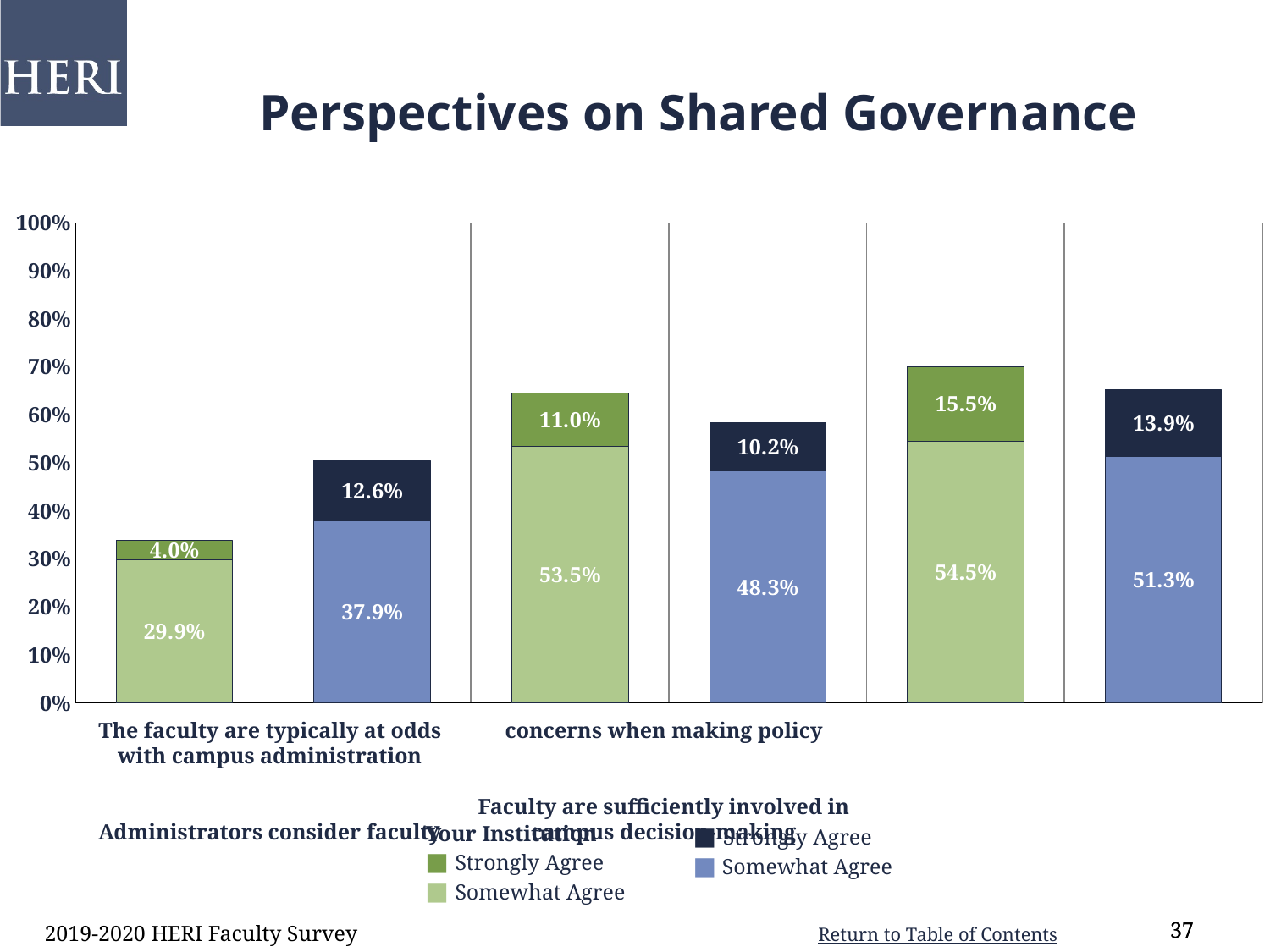
What is the total percentage agreeing (strongly plus somewhat) for Your Institution that faculty are sufficiently involved in campus decision making? 70.0% What percentage of Your Institution faculty somewhat agree that administrators consider faculty concerns when making policy? 53.5% Which statement has the highest Your Institution 'Strongly Agree' percentage? Faculty are sufficiently involved in campus decision making What is the difference between the Your Institution 'Somewhat Agree' value and the blue 'Somewhat Agree' value for 'Faculty are sufficiently involved in campus decision making'? 3.2% What is the title of the chart? Perspectives on Shared Governance In the blue bars, what percentage strongly agree that faculty are sufficiently involved in campus decision making? 13.9% What percentage of Your Institution faculty strongly agree that the faculty are typically at odds with campus administration? 4.0% In the blue bars, what percentage somewhat agree that the faculty are typically at odds with campus administration? 37.9% Which 'Strongly Agree' segment is larger for 'The faculty are typically at odds with campus administration': Your Institution (4.0%) or the blue bar (12.6%)? the blue bar (12.6%) How many statements (categories) are shown on the x axis? 3 What type of chart is shown on the slide? stacked bar chart What is the total percentage agreeing (strongly plus somewhat) in the blue bar for 'Administrators consider faculty concerns when making policy'? 58.5%